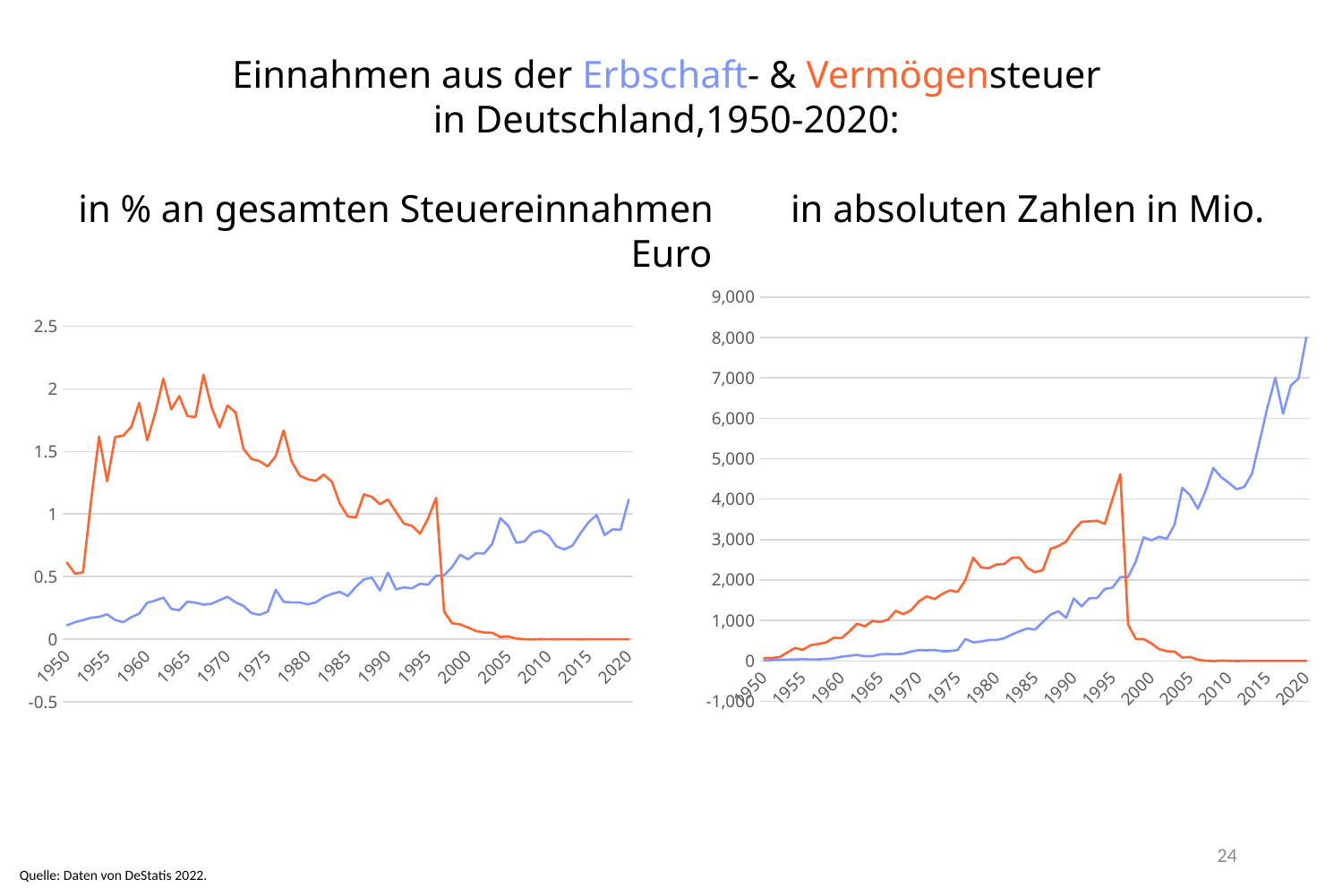
In the left chart, 'in % an gesamten Steuereinnahmen', which tax has the higher share in 1960, Erbschaftsteuer or Vermögensteuer? Vermögensteuer What kind of chart is the right chart, 'in absoluten Zahlen in Mio. Euro'? line chart In the left chart, 'in % an gesamten Steuereinnahmen', is the Vermögensteuer value in 1950 greater or less than 1? less In the right chart, 'in absoluten Zahlen in Mio. Euro', is the Erbschaftsteuer value in 2020 greater or less than 7,000? greater In the left chart, 'in % an gesamten Steuereinnahmen', does the Vermögensteuer line rise or fall between 1970 and 1995? fall In the left chart, 'in % an gesamten Steuereinnahmen', is the Erbschaftsteuer value in 2020 greater or less than 0.5? greater What colour is the line for the Erbschaftsteuer in both charts? blue How many lines are plotted in the right chart, 'in absoluten Zahlen in Mio. Euro'? 2 In the right chart, 'in absoluten Zahlen in Mio. Euro', does the Erbschaftsteuer line generally rise or fall from 1950 to 2020? rise What kind of chart is the left chart, 'in % an gesamten Steuereinnahmen'? line chart In the right chart, 'in absoluten Zahlen in Mio. Euro', which tax has the higher revenue in 2010, Erbschaftsteuer or Vermögensteuer? Erbschaftsteuer